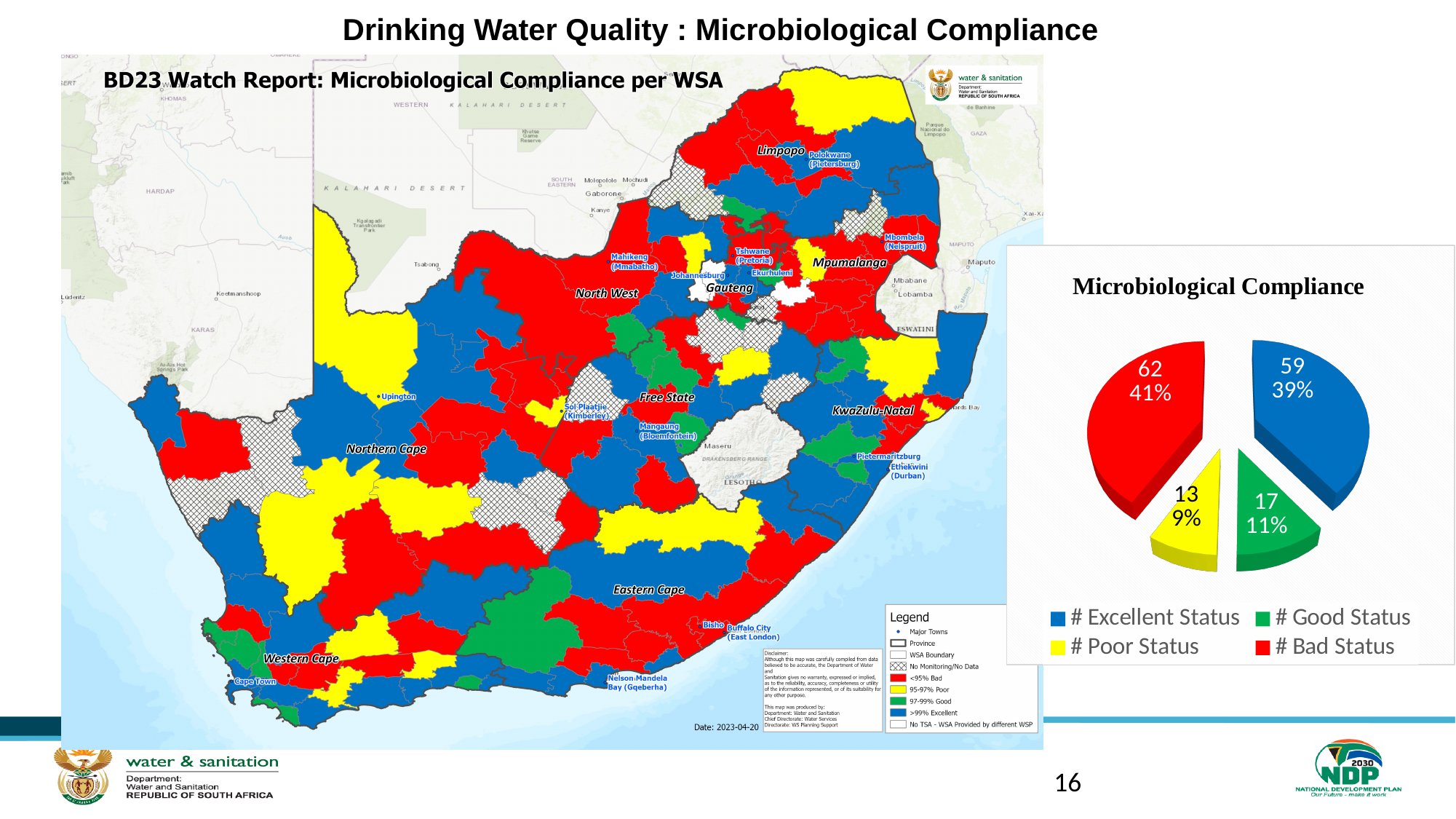
In the "Microbiological Compliance" pie chart, how many WSAs have Excellent Status? 59 In the "Microbiological Compliance" pie chart, what percentage share does Poor Status have? 9% In the "Microbiological Compliance" pie chart, what percentage share does Bad Status have? 41% In the "Microbiological Compliance" pie chart, what is the total of all four slice counts? 151 In the "Microbiological Compliance" pie chart, which status category has the largest slice? # Bad Status In the "Microbiological Compliance" pie chart, which status category has the smallest slice? # Poor Status In the "Microbiological Compliance" pie chart, which is larger: the Good Status count or the Poor Status count? Good Status In the "Microbiological Compliance" pie chart, what is the count for Good Status? 17 In the "Microbiological Compliance" pie chart, what colour represents Excellent Status? Blue How many categories does the legend of the "Microbiological Compliance" pie chart list? 4 What type of chart is the "Microbiological Compliance" chart on the right of the slide? Pie chart In the "Microbiological Compliance" pie chart, what is the difference between the Bad Status count and the Excellent Status count? 3